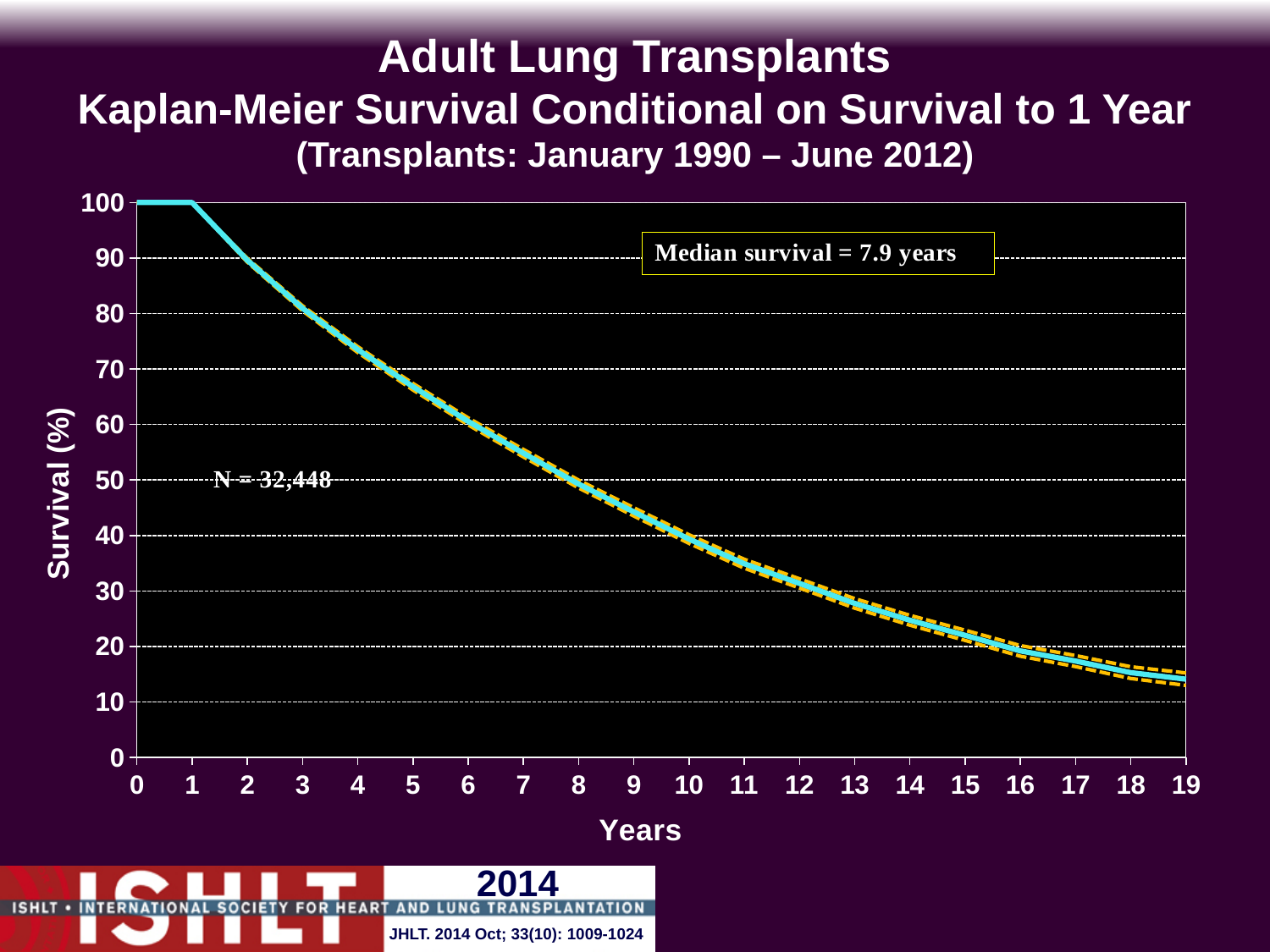
What type of chart is shown on the slide? line chart Which year has the highest survival value, year 1 or year 10? year 1 Is the survival value at year 18 greater or less than 20? less What is the label of the y axis? Survival (%) What is the value of N shown on the chart? 32,448 What is the survival percentage at year 1? 100 What is the median survival stated on the chart? 7.9 years What is the highest value shown on the x axis? 19 Is the survival value at year 13 greater or less than 30? less Is the survival value at year 7 greater or less than 50? greater Does survival rise or fall as years increase along the x axis? fall